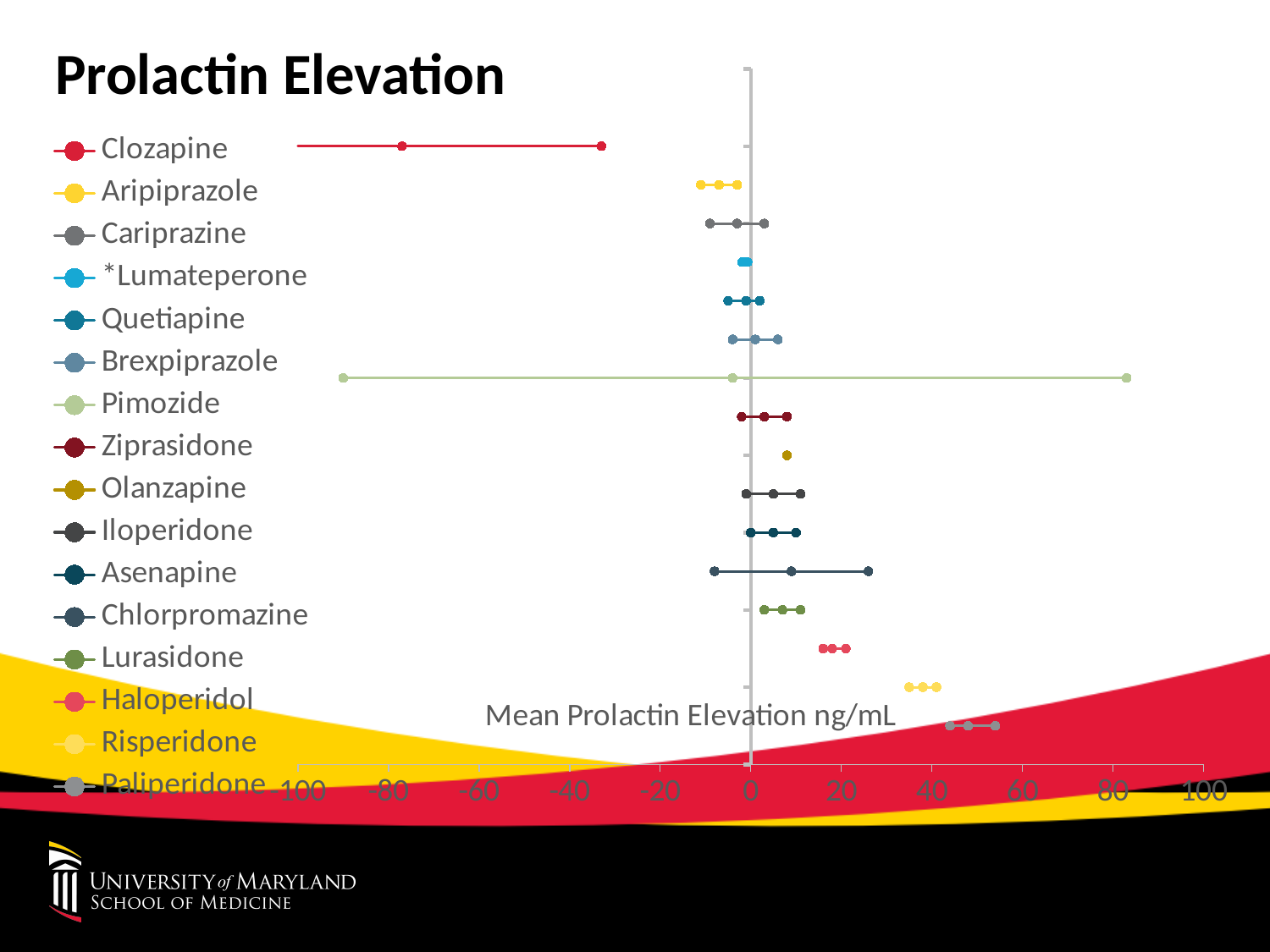
Which drug has the lowest mean prolactin elevation on the chart? Clozapine Is the mean prolactin elevation for Risperidone greater or less than 20? greater Is the mean prolactin elevation for Aripiprazole greater or less than 0? less What is the title of the chart? Prolactin Elevation Which drug has the highest mean prolactin elevation on the chart? Paliperidone Is the mean prolactin elevation for Paliperidone greater or less than 40? greater Which has a lower mean prolactin elevation, Clozapine or Aripiprazole? Clozapine What is the label on the horizontal axis of the chart? Mean Prolactin Elevation ng/mL How many drugs (series) does the legend list? 16 Which has a higher mean prolactin elevation, Paliperidone or Risperidone? Paliperidone